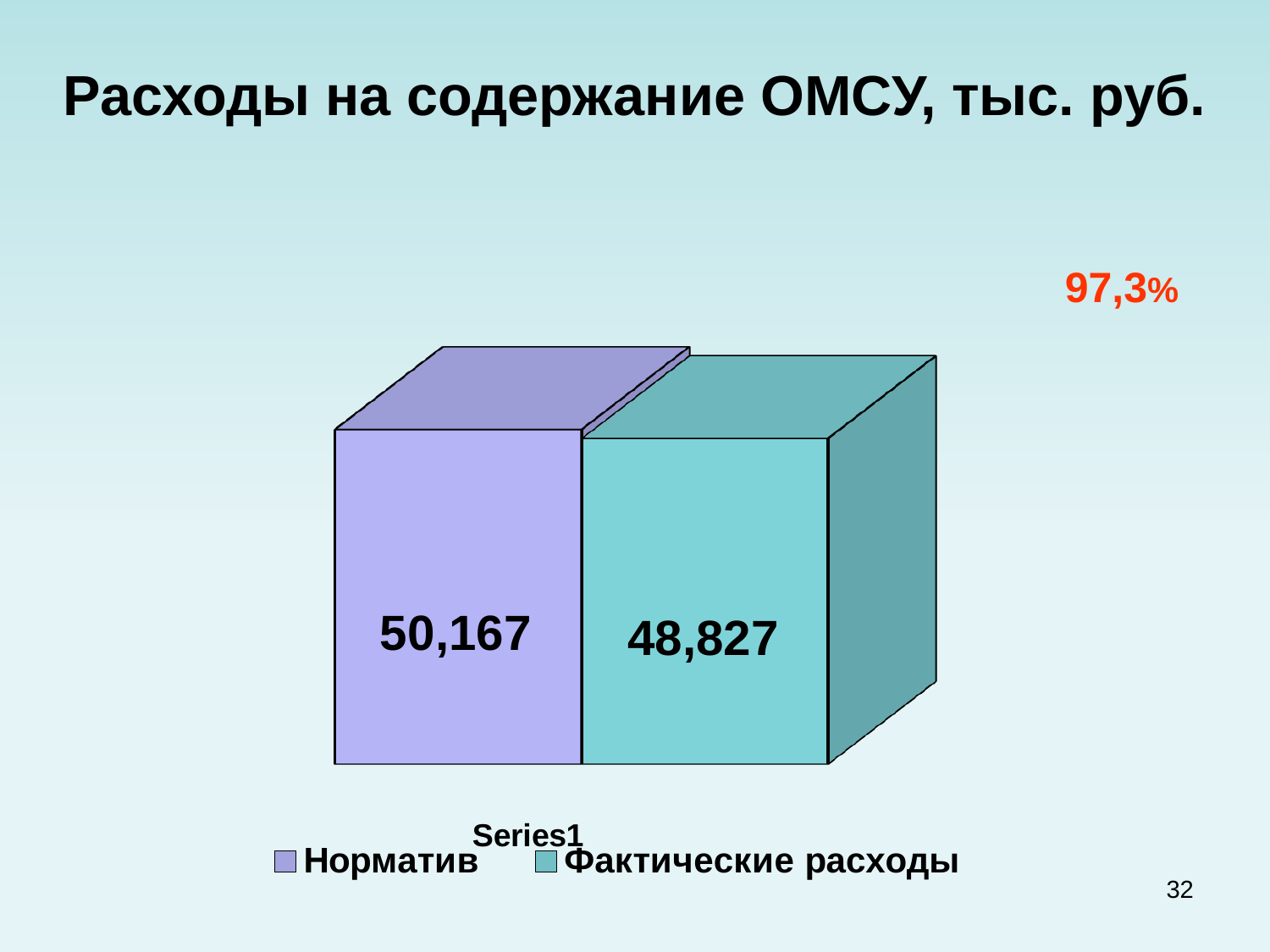
What is the title of the chart? Расходы на содержание ОМСУ, тыс. руб. Which bar shows the lowest value? Фактические расходы What kind of chart is shown on the slide? Bar chart What is the value of the Норматив bar? 50,167 What is the value of the Фактические расходы bar? 48,827 What is the difference between the Норматив value and the Фактические расходы value? 1,340 How many series does the legend list? 2 What percentage is printed in red at the top right of the chart? 97,3% Which series has the higher value, Норматив or Фактические расходы? Норматив Which bar shows the highest value? Норматив How many bars are plotted on the chart? 2